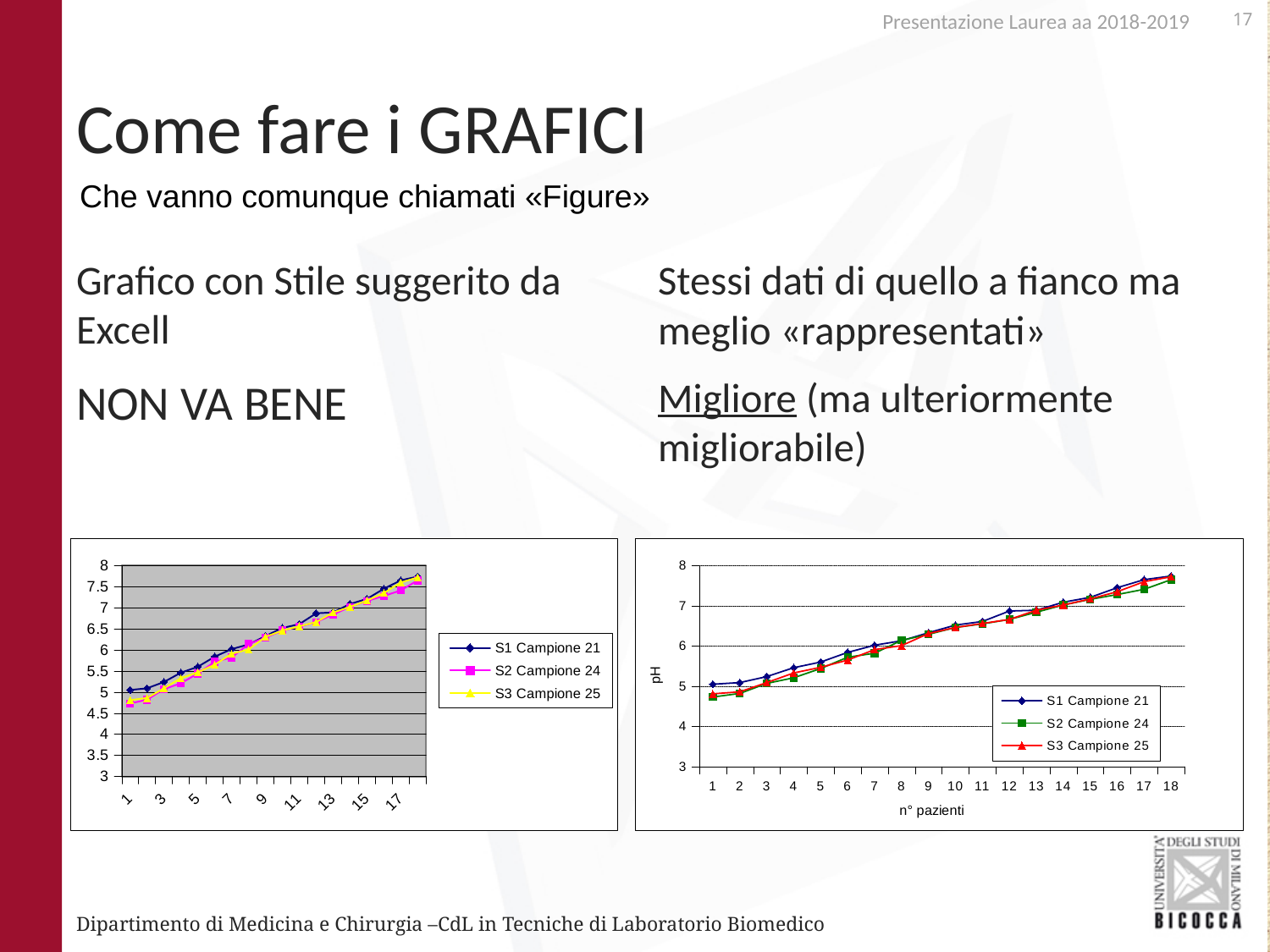
In the chart on the right, is the value of S3 Campione 25 for patient 9 greater or less than 7? less In the chart on the right, what is the label of the y axis? pH In the chart on the right, is the value of S1 Campione 21 for patient 18 greater or less than 7? greater What kind of chart is the chart on the left of the slide? line chart What kind of chart is the chart on the right of the slide? line chart In the chart on the right, is the value of S2 Campione 24 for patient 1 greater or less than 5? less In the chart on the right, for which patient number does S1 Campione 21 reach its highest value? 18 In the chart on the right, do the pH values rise or fall as the patient number increases? rise In the chart on the right, how many patients (points) are labelled on the x axis? 18 In the chart on the right, which series has the highest value for patient 1? S1 Campione 21 In the chart on the right, what is the label of the x axis? n° pazienti In the chart on the right, how many series does the legend list? 3